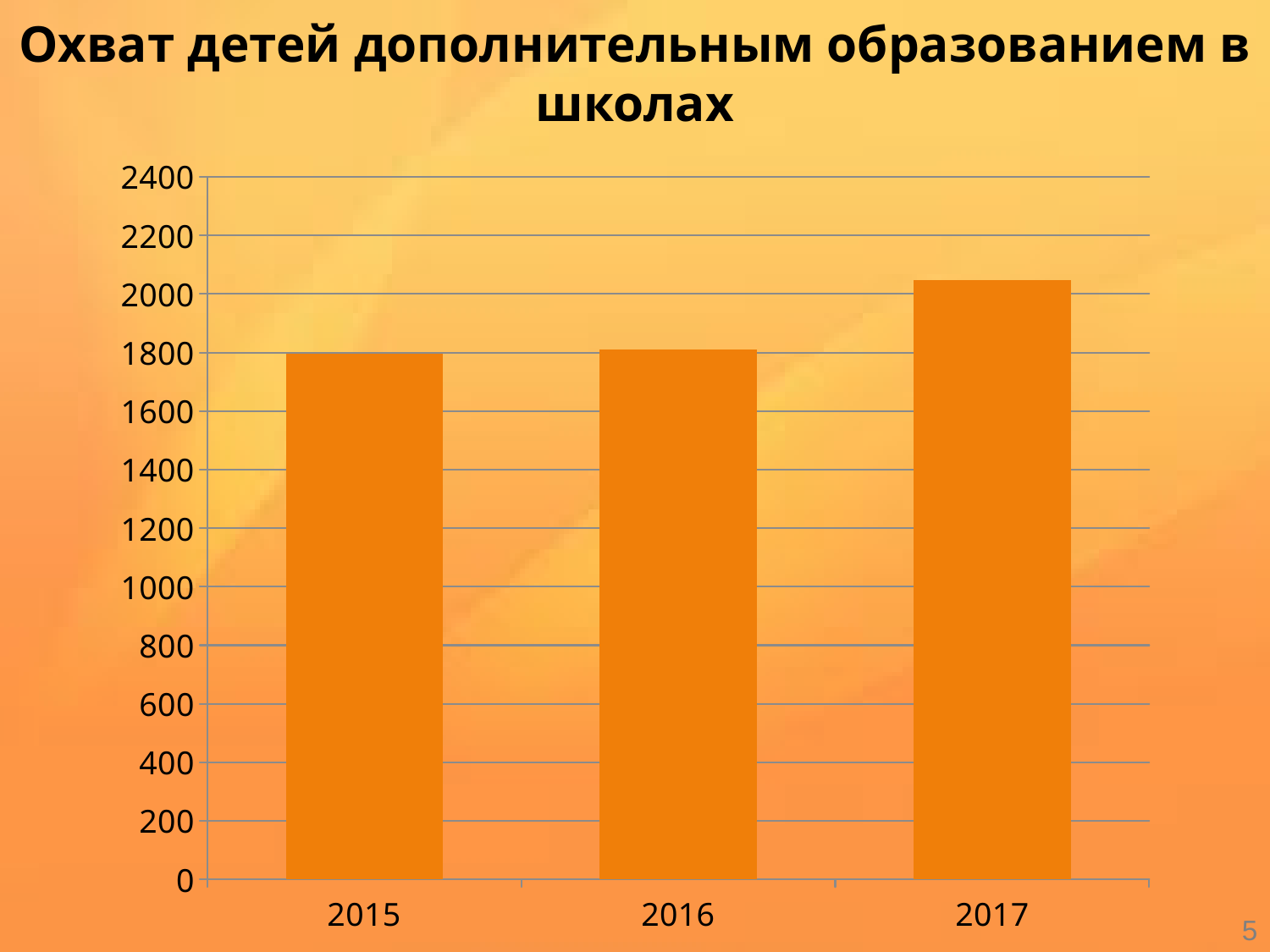
Is the value for 2015 greater or less than 1600? greater What is the title of the chart on the slide? Охват детей дополнительным образованием в школах Do the values rise or fall from 2015 to 2017? rise Is the value for 2016 greater or less than 2000? less What kind of chart is shown on the slide? bar chart Which is larger, the value for 2015 or the value for 2017? 2017 Which year has the highest value in the chart? 2017 How many years are shown on the x axis of the chart? 3 Is the value for 2017 greater or less than 2000? greater What is the highest value shown on the vertical axis of the chart? 2400